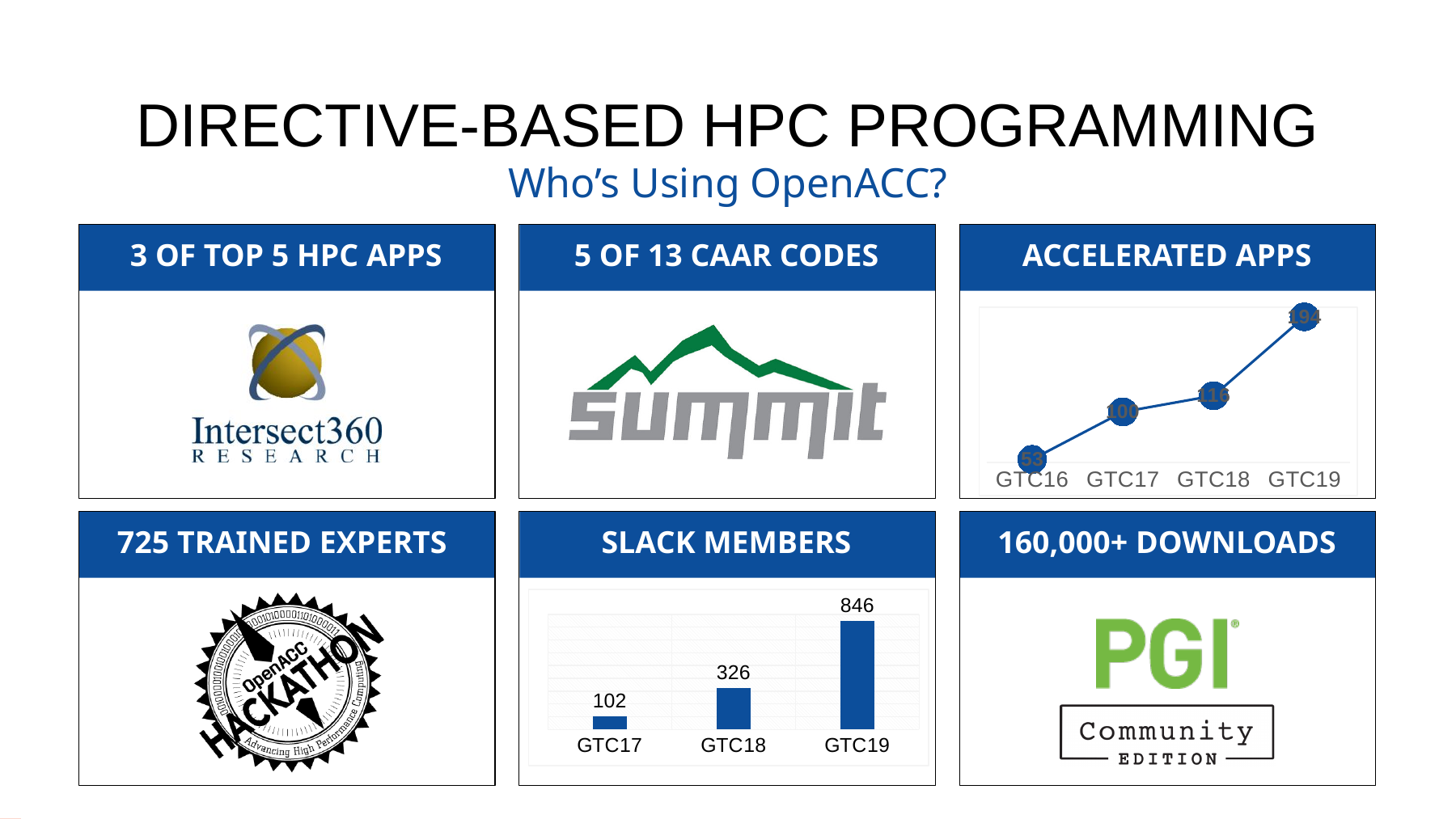
What kind of chart is the Accelerated Apps chart? line chart In the Slack Members chart, what is the value for GTC18? 326 In the Accelerated Apps chart, do the values rise or fall from GTC16 to GTC19? rise In the Slack Members chart, how many categories are shown? 3 In the Slack Members chart, which category has the highest value? GTC19 In the Accelerated Apps chart, what is the value for GTC19? 194 In the Slack Members chart, which category has the lowest value? GTC17 What kind of chart is the Slack Members chart? bar chart In the Slack Members chart, what is the value for GTC17? 102 In the Slack Members chart, what is the value for GTC19? 846 In the Slack Members chart, what is the difference between the GTC19 and GTC18 values? 520 In the Accelerated Apps chart, which category has the lowest value? GTC16